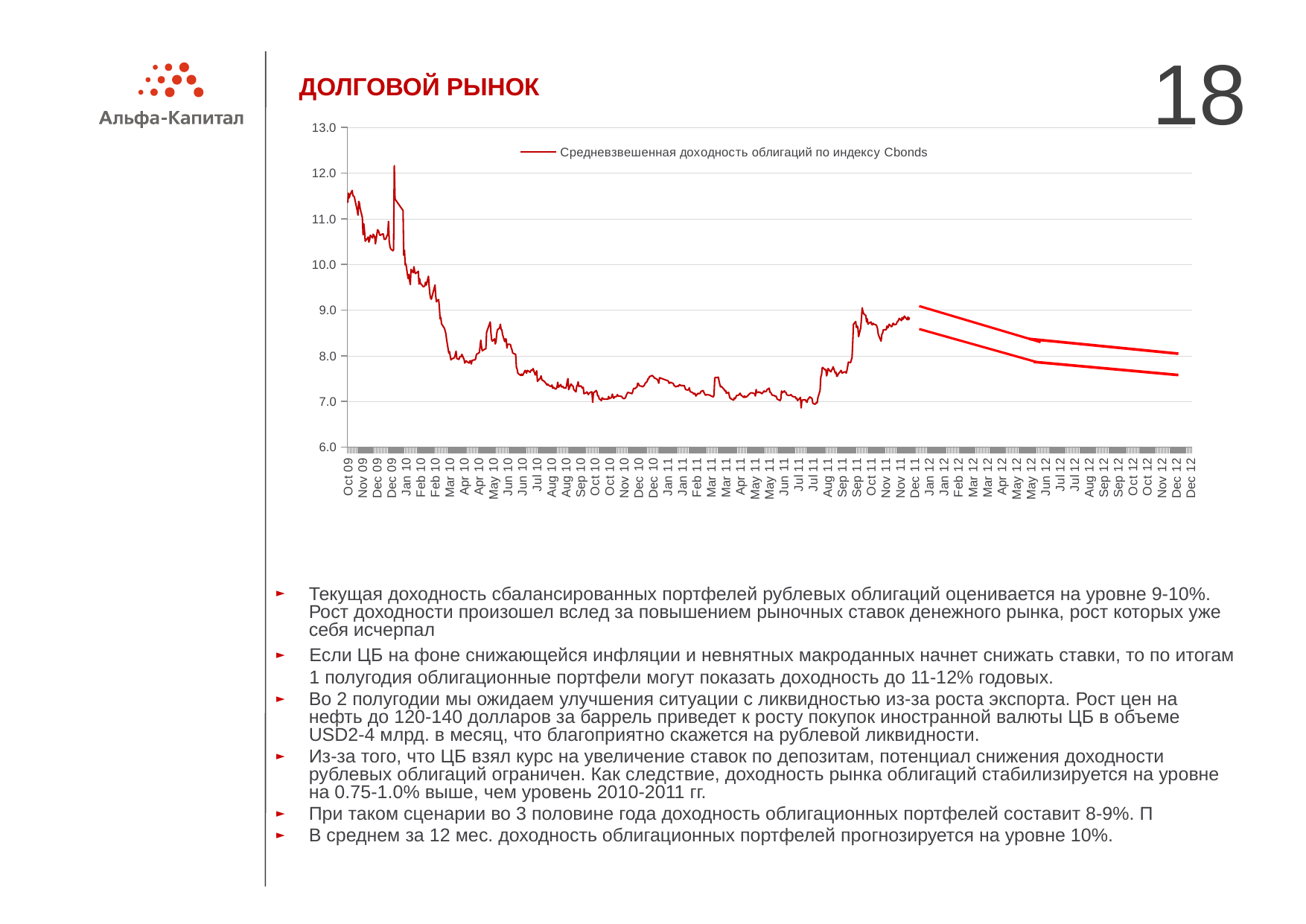
Around which month does the Cbonds yield index reach its highest point on the chart? Dec 09 Is the value of the Cbonds yield index at Oct 09 greater or less than 11.0? greater What is the highest value shown on the vertical axis of the chart? 13.0 What kind of chart is shown on the slide? line chart Which is larger, the Cbonds yield index at Oct 09 or at Dec 11? Oct 09 How many series does the chart legend list? 1 Is the value of the Cbonds yield index at Oct 10 greater or less than 8.0? less Does the Cbonds yield index rise or fall between Oct 09 and Jul 11? fall Is the value of the Cbonds yield index at Nov 11 greater or less than 8.0? greater What is the name of the series shown in the chart legend? Средневзвешенная доходность облигаций по индексу Cbonds